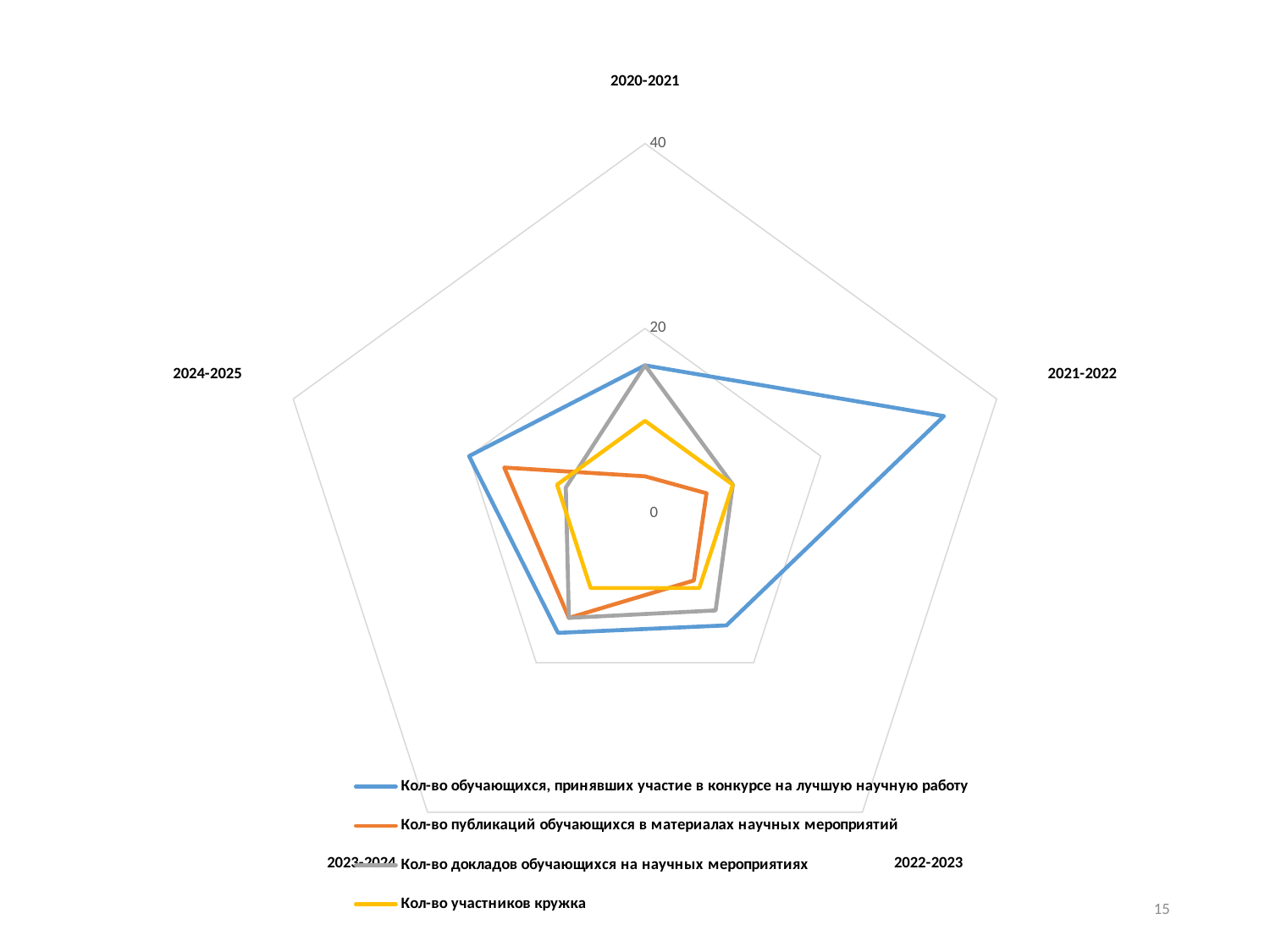
In which academic year does "Кол-во обучающихся, принявших участие в конкурсе на лучшую научную работу" reach its highest value? 2021-2022 Is the value of "Кол-во участников кружка" for 2022-2023 greater or less than 20? less In which academic year does "Кол-во публикаций обучающихся в материалах научных мероприятий" have its lowest value? 2020-2021 For 2024-2025, which is larger: "Кол-во публикаций обучающихся в материалах научных мероприятий" or "Кол-во участников кружка"? Кол-во публикаций обучающихся в материалах научных мероприятий Is the value of "Кол-во публикаций обучающихся в материалах научных мероприятий" for 2020-2021 greater or less than 20? less How many academic-year categories does the radar chart have? 5 What colour is the line for "Кол-во участников кружка" in the legend? Yellow For 2021-2022, which is larger: "Кол-во обучающихся, принявших участие в конкурсе на лучшую научную работу" or "Кол-во публикаций обучающихся в материалах научных мероприятий"? Кол-во обучающихся, принявших участие в конкурсе на лучшую научную работу Is the value of "Кол-во обучающихся, принявших участие в конкурсе на лучшую научную работу" for 2020-2021 greater or less than 20? less How many series does the legend list? 4 What kind of chart is shown on the slide? Radar chart